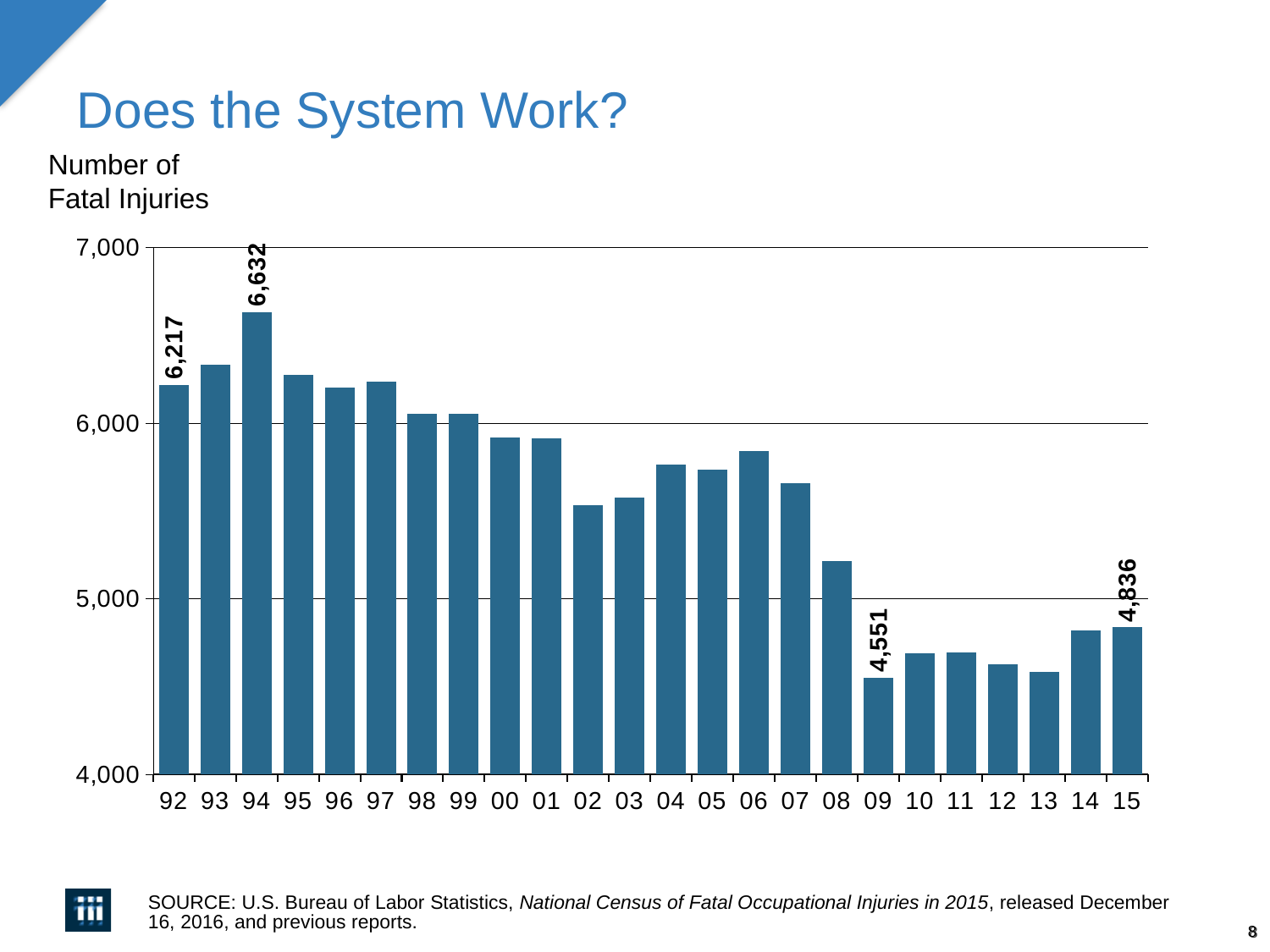
Which year has the lowest number of fatal injuries? 09 How many years are shown on the x axis of the chart? 24 Which year has more fatal injuries, 92 or 15? 92 What is the number of fatal injuries shown for 94? 6,632 Is the value for 08 greater or less than 5,000? greater What is the difference between the number of fatal injuries in 94 and in 09? 2,081 Which year has the highest number of fatal injuries? 94 What is the number of fatal injuries shown for 15? 4,836 What is the number of fatal injuries shown for 92? 6,217 What kind of chart is shown on the slide? Bar chart What is the number of fatal injuries shown for 09? 4,551 What is the difference between the number of fatal injuries in 15 and in 09? 285